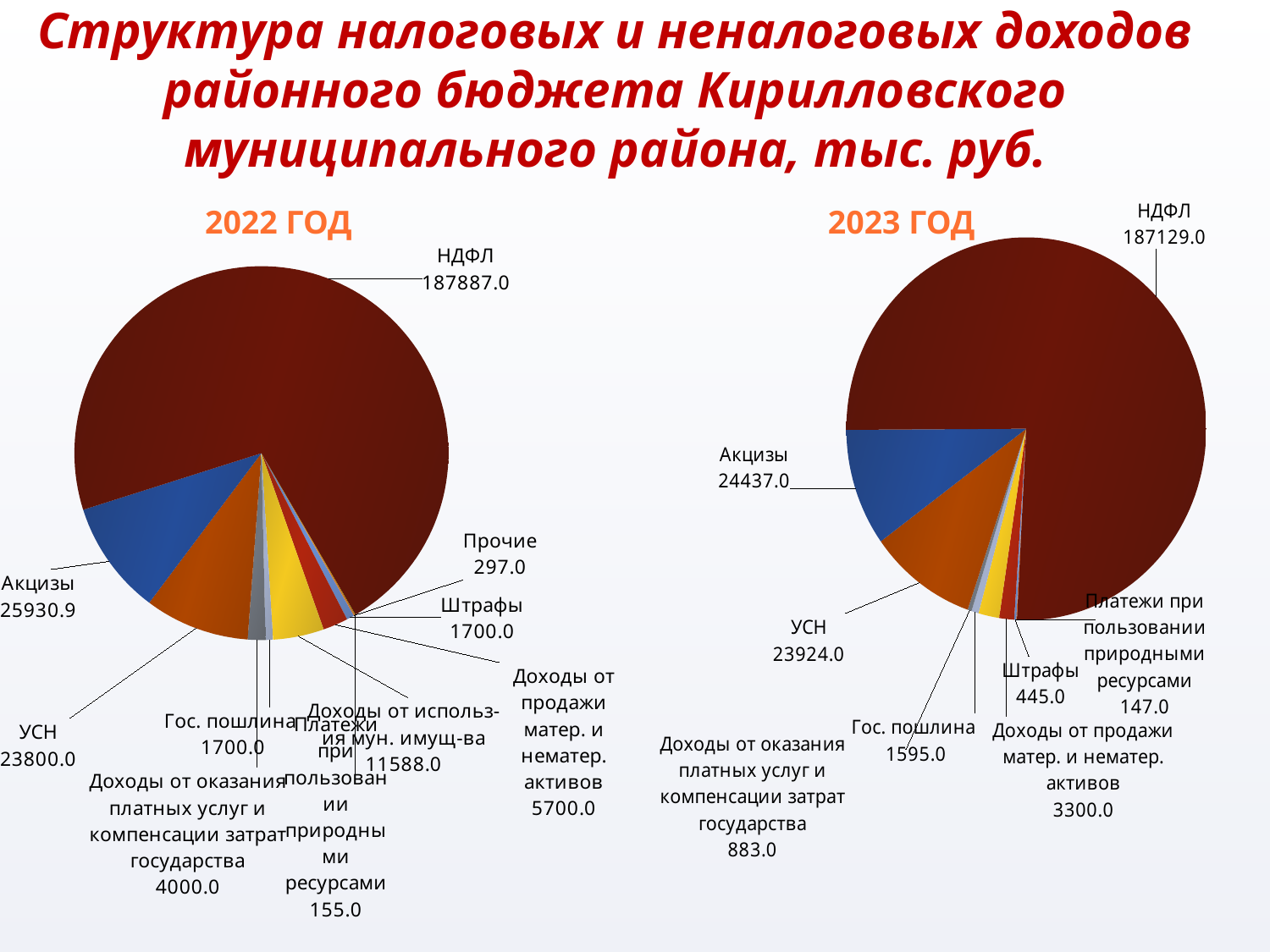
In the 2023 ГОД chart, what is the value for Штрафы? 445.0 In the 2022 ГОД chart, what is the value for НДФЛ? 187887.0 What type of charts are shown on the slide? Pie charts In the 2022 ГОД chart, which category has the largest value? НДФЛ In the 2023 ГОД chart, what is the value for Акцизы? 24437.0 How many categories are labelled in the 2023 ГОД chart? 8 In the 2022 ГОД chart, which is larger: Акцизы or УСН? Акцизы In the 2023 ГОД chart, which category has the smallest value? Платежи при пользовании природными ресурсами What is the difference between the НДФЛ value in the 2022 ГОД chart and the НДФЛ value in the 2023 ГОД chart? 758.0 What is the difference between УСН in the 2023 ГОД chart and УСН in the 2022 ГОД chart? 124.0 In the 2022 ГОД chart, what is the value for Доходы от использования мун. имущ-ва? 11588.0 In the 2022 ГОД chart, which category has the smallest value? Платежи при пользовании природными ресурсами